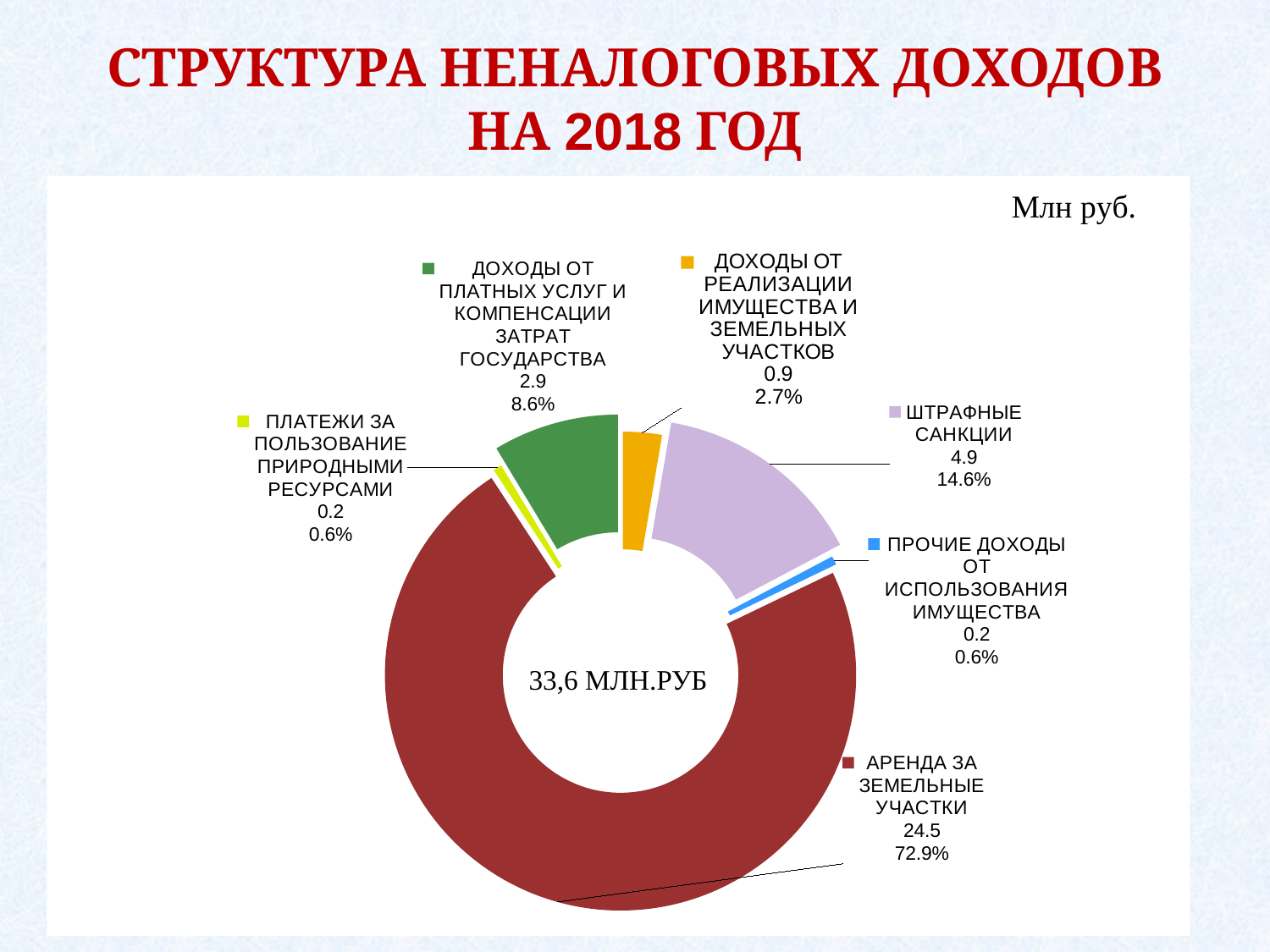
Which category has the largest share of the chart? АРЕНДА ЗА ЗЕМЕЛЬНЫЕ УЧАСТКИ Which is larger: ШТРАФНЫЕ САНКЦИИ or ДОХОДЫ ОТ РЕАЛИЗАЦИИ ИМУЩЕСТВА И ЗЕМЕЛЬНЫХ УЧАСТКОВ? ШТРАФНЫЕ САНКЦИИ What kind of chart is shown on the slide? Doughnut (pie) chart What is the difference between the values for ШТРАФНЫЕ САНКЦИИ and ДОХОДЫ ОТ ПЛАТНЫХ УСЛУГ И КОМПЕНСАЦИИ ЗАТРАТ ГОСУДАРСТВА? 2.0 What is the value for АРЕНДА ЗА ЗЕМЕЛЬНЫЕ УЧАСТКИ? 24.5 What is the value for ДОХОДЫ ОТ ПЛАТНЫХ УСЛУГ И КОМПЕНСАЦИИ ЗАТРАТ ГОСУДАРСТВА? 2.9 What total is shown in the centre of the chart? 33,6 МЛН.РУБ What percentage is shown for ДОХОДЫ ОТ РЕАЛИЗАЦИИ ИМУЩЕСТВА И ЗЕМЕЛЬНЫХ УЧАСТКОВ? 2.7% How many categories are shown in the chart? 6 What is the value for ПРОЧИЕ ДОХОДЫ ОТ ИСПОЛЬЗОВАНИЯ ИМУЩЕСТВА? 0.2 What is the title of the slide? СТРУКТУРА НЕНАЛОГОВЫХ ДОХОДОВ НА 2018 ГОД What share of the chart does ШТРАФНЫЕ САНКЦИИ represent? 14.6%